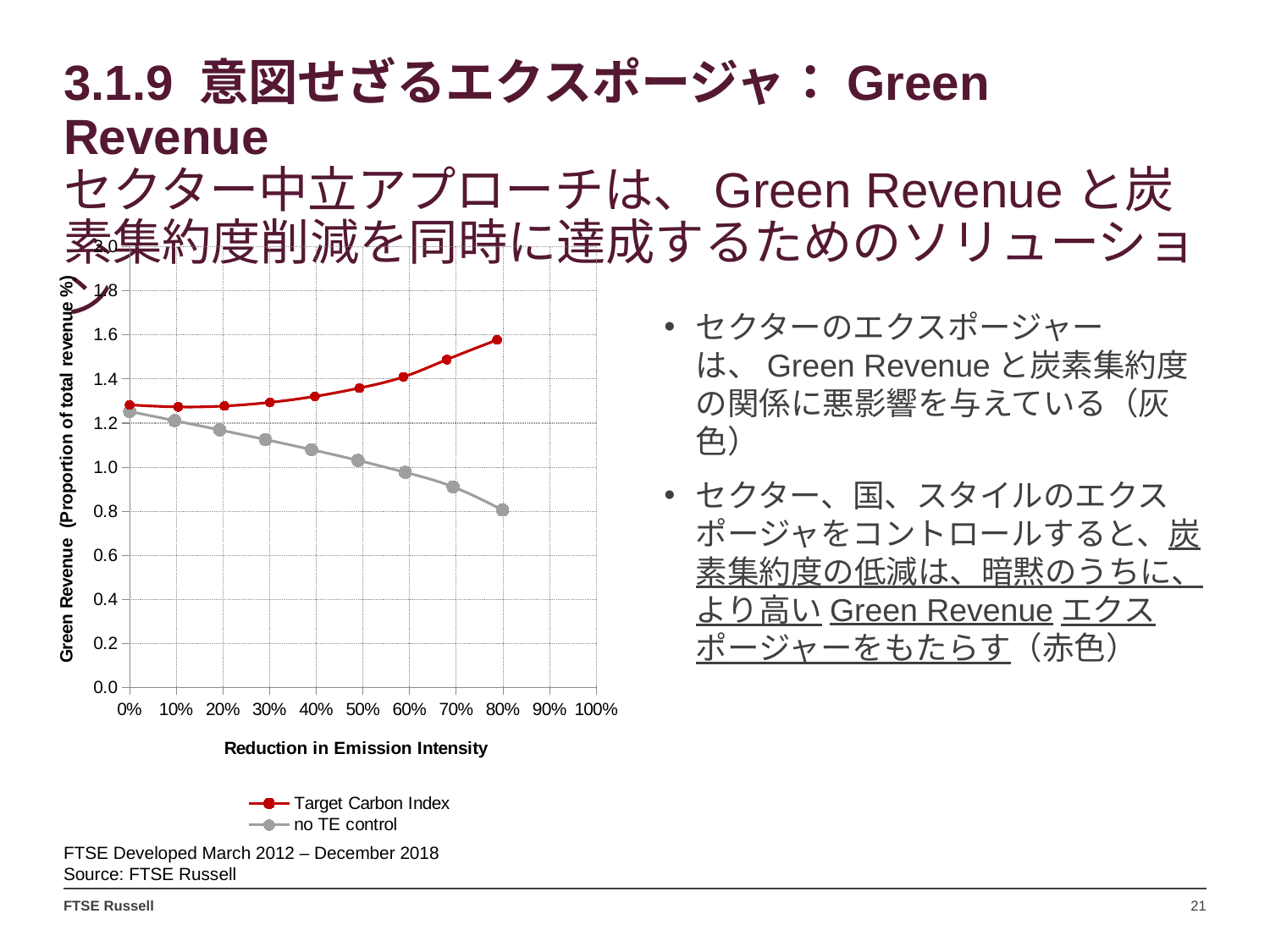
What is the title of the chart's x axis? Reduction in Emission Intensity What kind of chart is shown on the slide? line chart Does the no TE control line rise or fall as Reduction in Emission Intensity increases? fall At 80% Reduction in Emission Intensity, which series has the higher Green Revenue value, Target Carbon Index or no TE control? Target Carbon Index At which Reduction in Emission Intensity level does the Target Carbon Index series reach its highest value? 80% Is the no TE control value at 80% Reduction in Emission Intensity greater or less than 1.0? less How many series does the chart's legend list? 2 Is the no TE control value at 0% Reduction in Emission Intensity greater or less than 1.0? greater Does the Target Carbon Index line rise or fall as Reduction in Emission Intensity increases? rise At which Reduction in Emission Intensity level does the no TE control series reach its lowest value? 80% Is the Target Carbon Index value at 80% Reduction in Emission Intensity greater or less than 1.4? greater How many data points are plotted for the Target Carbon Index series? 9